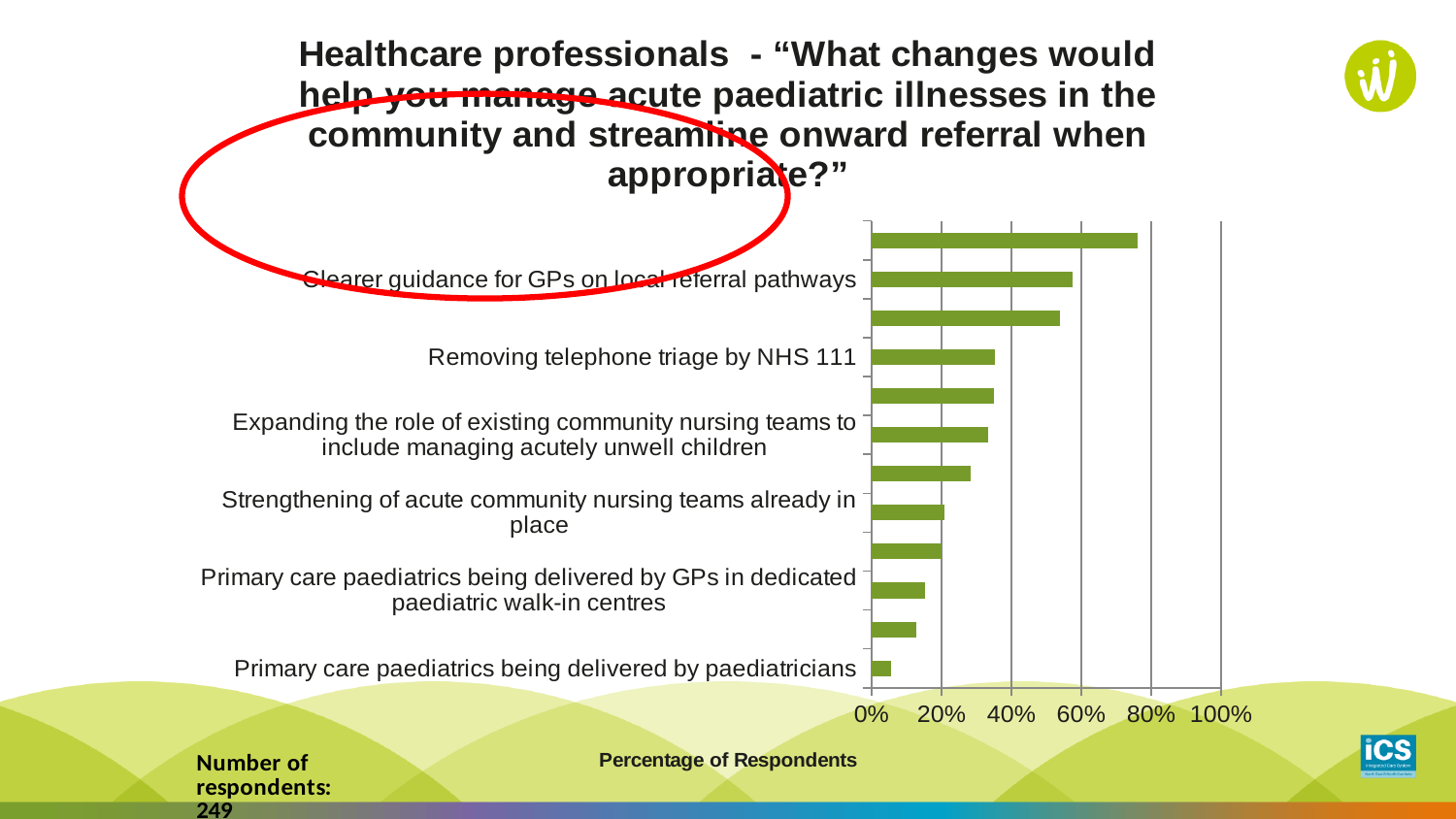
Is the value for 'Primary care paediatrics being delivered by paediatricians' greater or less than 20%? less Which of the labelled categories has the shortest bar? Primary care paediatrics being delivered by paediatricians Which is larger: the value for 'Removing telephone triage by NHS 111' or for 'Primary care paediatrics being delivered by GPs in dedicated paediatric walk-in centres'? Removing telephone triage by NHS 111 Which of the labelled categories has the longest bar? Clearer guidance for GPs on local referral pathways How many bars are plotted in the chart? 12 Which is larger: the value for 'Clearer guidance for GPs on local referral pathways' or for 'Removing telephone triage by NHS 111'? Clearer guidance for GPs on local referral pathways What is the title of the horizontal axis? Percentage of Respondents Is the value for 'Expanding the role of existing community nursing teams to include managing acutely unwell children' greater or less than 20%? greater Is the value for 'Removing telephone triage by NHS 111' greater or less than 40%? less Do the bar lengths increase or decrease going from the top of the chart to the bottom? decrease What kind of chart is shown on the slide? bar chart